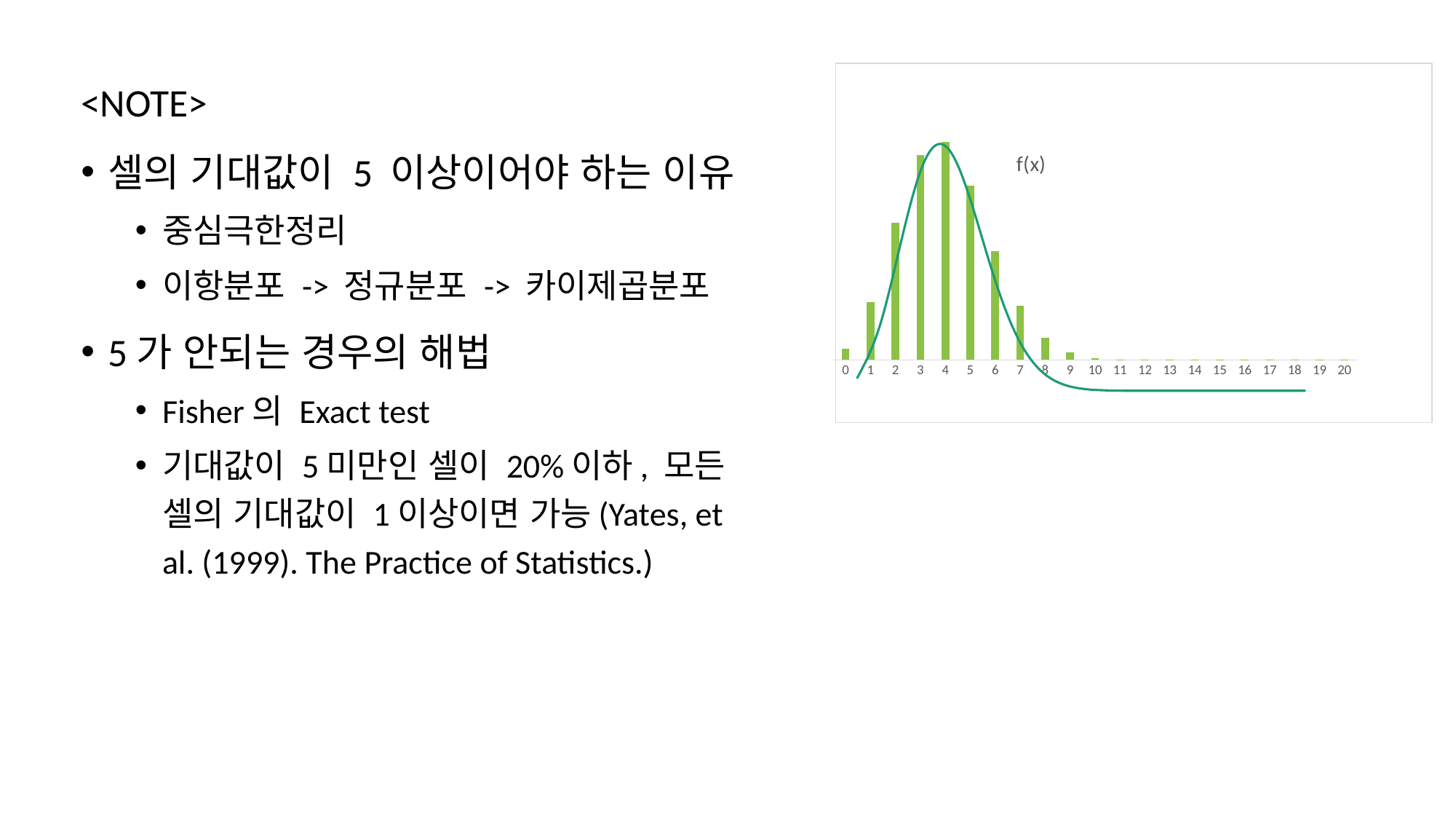
Which bar is taller, the one at 5 or the one at 3? 3 Which bar is taller, the one at 1 or the one at 8? 1 Do the bar heights rise or fall from x = 0 to x = 4? rise What is the label shown next to the curve overlaid on the bars? f(x) Which bar is taller, the one at 3 or the one at 7? 3 What colour are the bars in the chart? green Which x-axis category has the tallest bar? 4 How many categories are labelled on the x axis? 21 What kind of chart is shown on the slide? bar chart What is the first category label on the x axis? 0 Do the bar heights rise or fall from x = 4 to x = 9? fall